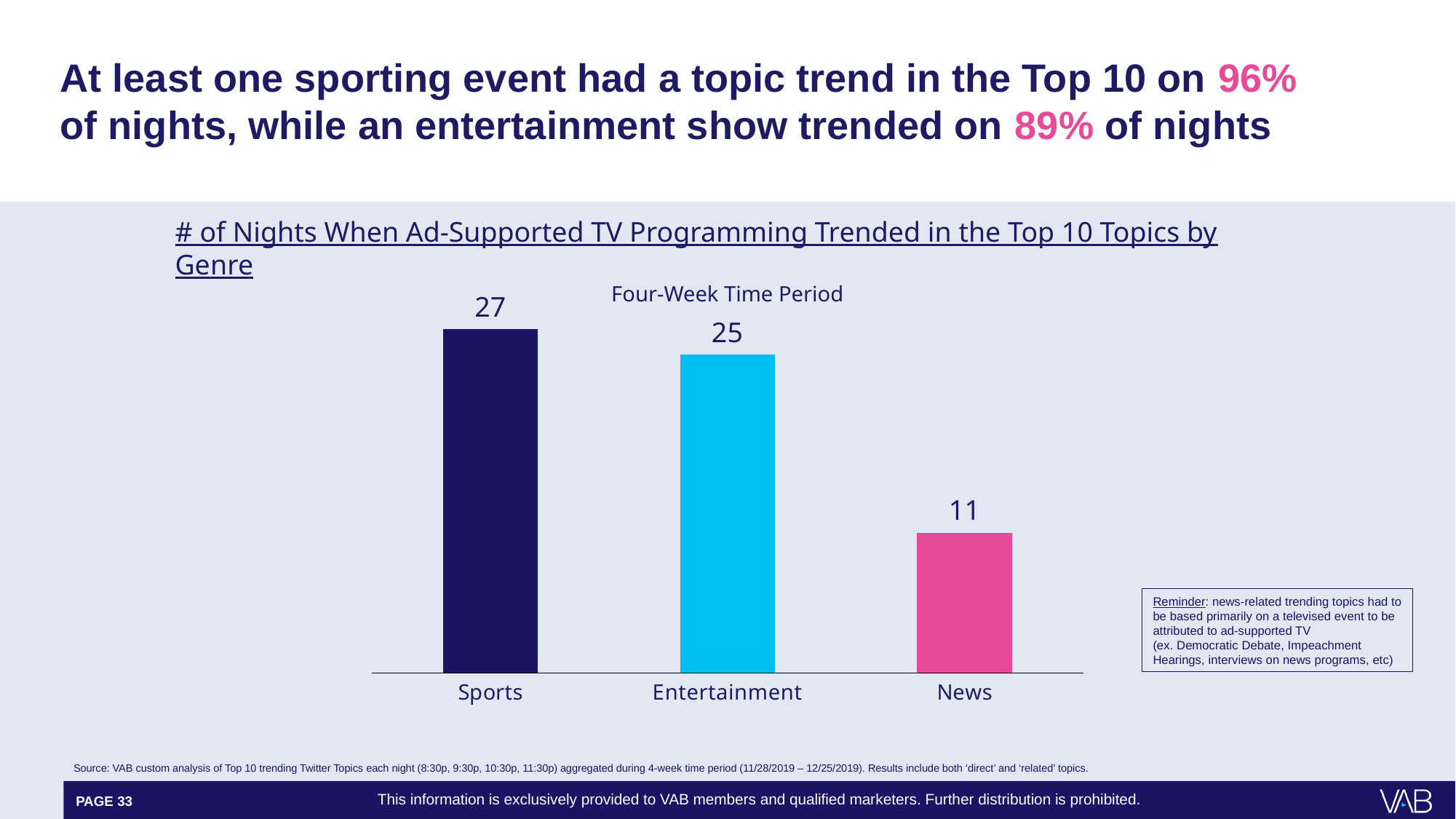
What is the number of nights for Sports? 27 Which genre has the lowest number of nights? News What kind of chart is shown on the slide? Bar chart What time period does the chart subtitle say the data covers? Four-Week Time Period What is the number of nights for News? 11 What is the number of nights for Entertainment? 25 Which has more nights, Entertainment or News? Entertainment What is the difference in nights between Sports and Entertainment? 2 Which genre has the highest number of nights? Sports How many genres are shown in the chart? 3 Do the values rise or fall from left to right across the genres? Fall What is the difference in nights between Sports and News? 16